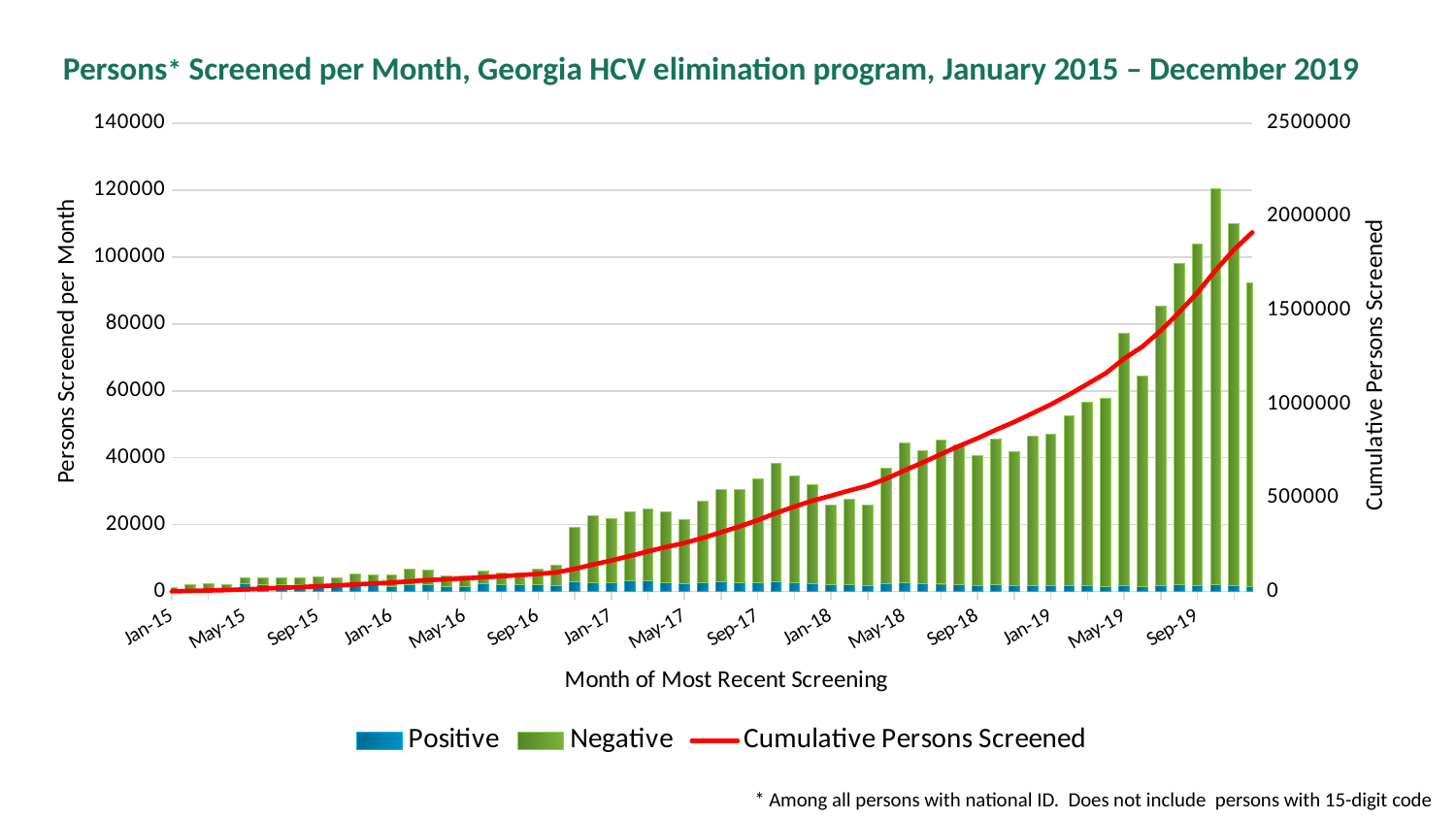
Is the number of persons screened in Sep-19 greater or less than 100000? greater Is the number of persons screened in May-19 greater or less than 60000? greater How many month labels are shown on the x axis? 15 How many series does the legend list? 3 Is the number of persons screened in Jan-19 greater or less than 40000? greater Does the Cumulative Persons Screened line rise or fall from Jan-15 to the end of 2019? Rises What is the title of the chart? Persons* Screened per Month, Georgia HCV elimination program, January 2015 – December 2019 Which month had more persons screened, Jan-15 or Sep-19? Sep-19 What are the three series named in the legend? Positive, Negative, Cumulative Persons Screened What kind of chart is shown on the slide? A combined bar and line chart